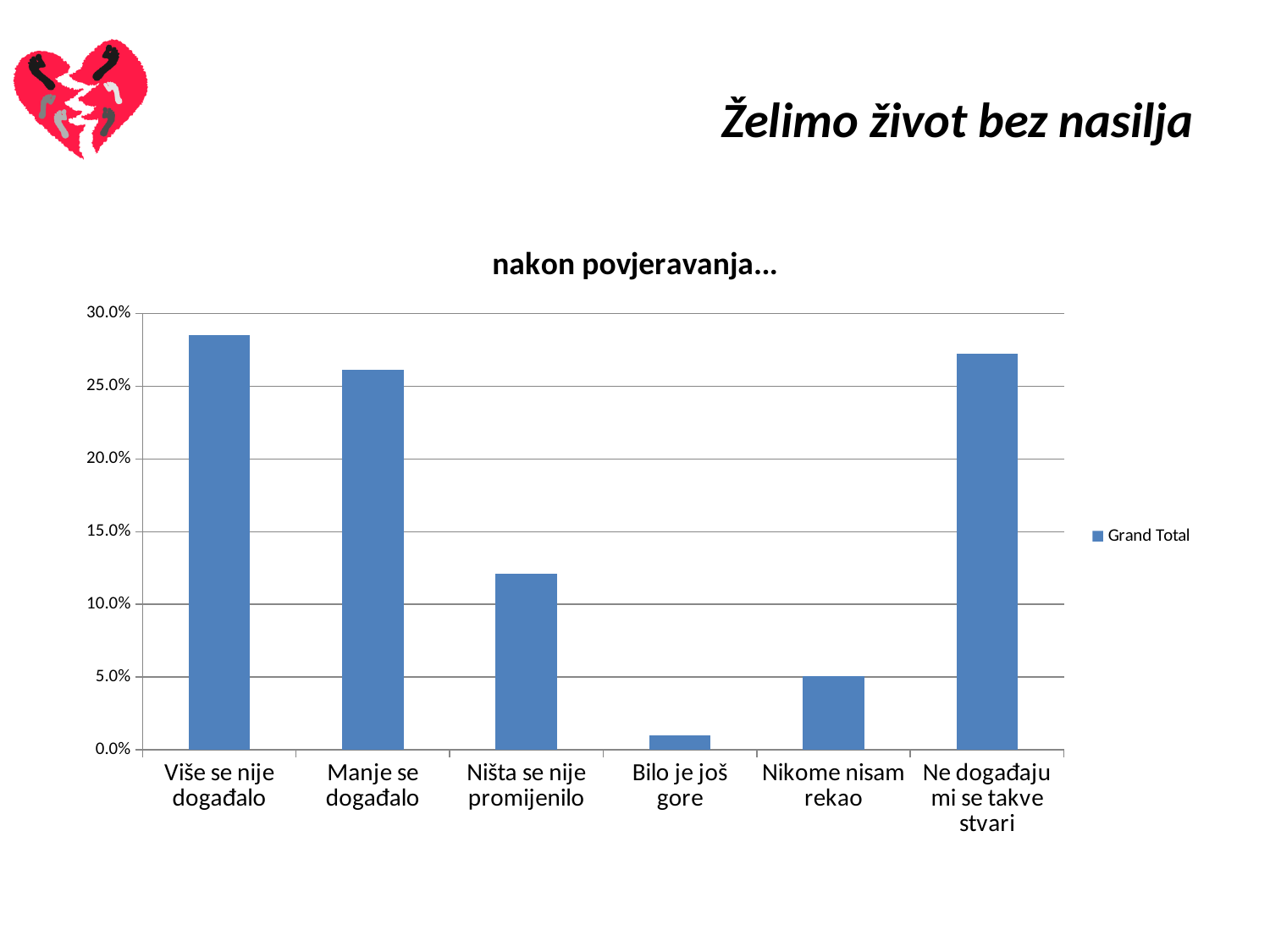
Is the value for Ništa se nije promijenilo greater or less than 15.0%? less Which category has the highest value in the chart? Više se nije događalo Is the value for Ne događaju mi se takve stvari greater or less than 25.0%? greater What is the title of the chart? nakon povjeravanja... How many series does the chart legend list? 1 Is the value for Bilo je još gore greater or less than 5.0%? less How many categories are shown on the x axis of the chart? 6 Which is larger, the value for Ništa se nije promijenilo or the value for Nikome nisam rekao? Ništa se nije promijenilo What is the name of the series shown in the chart legend? Grand Total What kind of chart is shown on the slide? bar chart Which category has the lowest value in the chart? Bilo je još gore